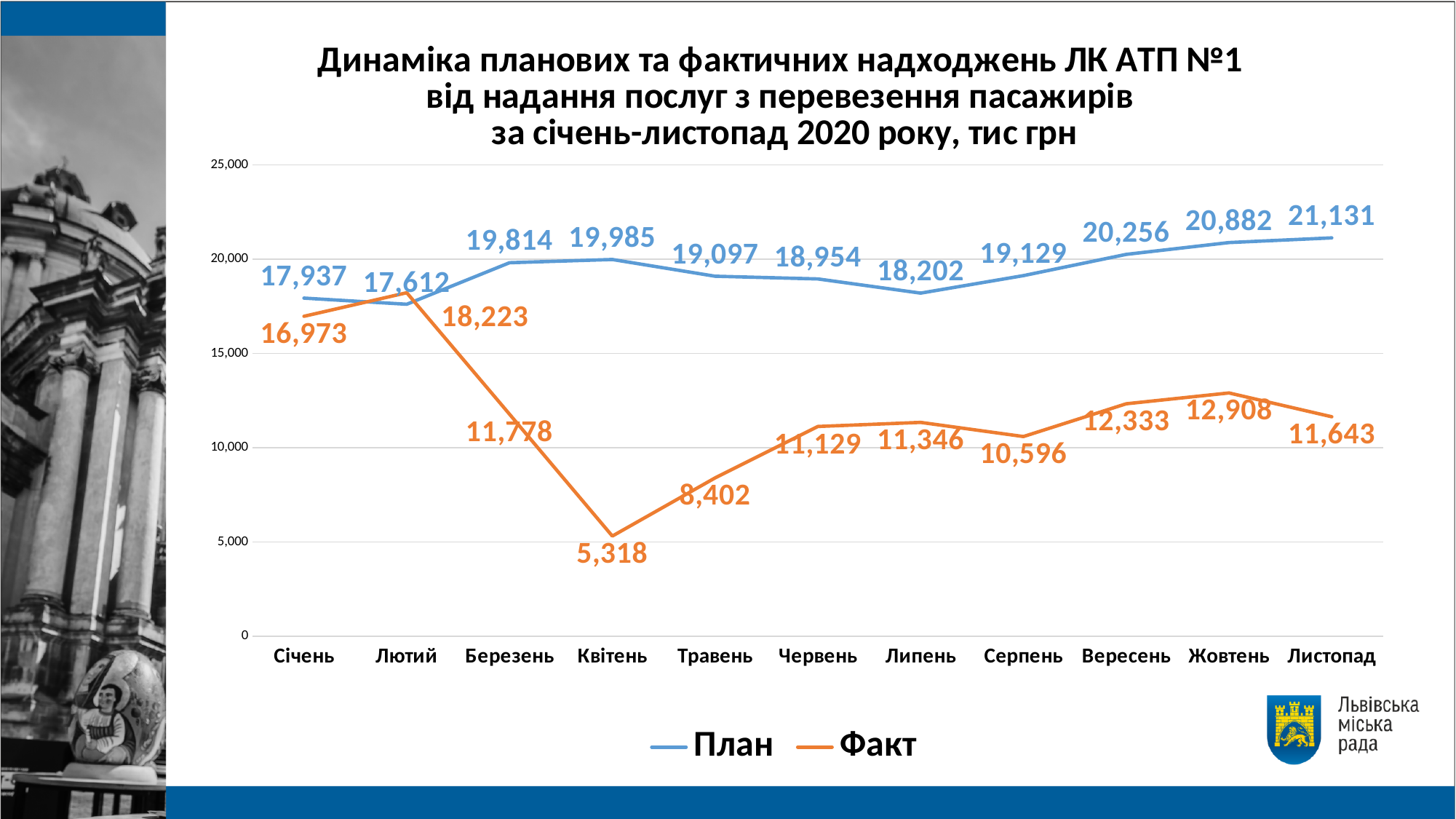
What is the План value for Листопад? 21,131 In which month is the Факт value lowest? Квітень What kind of chart is shown on the slide? Line chart What is the Факт value for Жовтень? 12,908 What is the Факт value for Квітень? 5,318 How many months are shown on the x axis? 11 In which month is the Факт value highest? Лютий Does the План line rise or fall from Серпень to Листопад? Rise How many series does the legend list? 2 In which month is the План value highest? Листопад What is the difference between the План and Факт values in Квітень? 14,667 In Лютий, which is larger: План or Факт? Факт